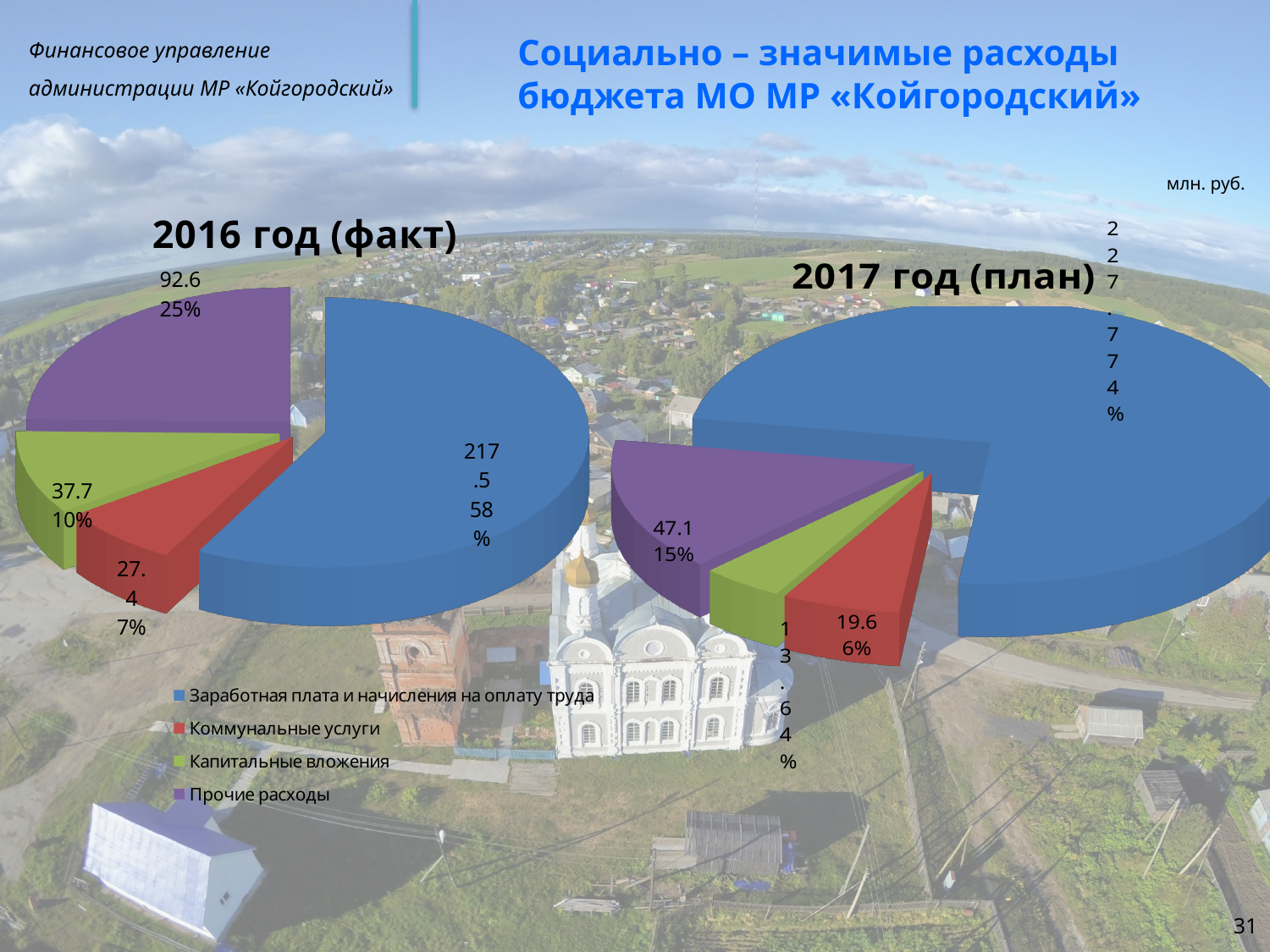
In the 2017 год (план) chart, what is the value for Прочие расходы? 47.1 In the 2016 год (факт) chart, what is the value for Заработная плата и начисления на оплату труда? 217.5 What unit is indicated for the values on the slide? млн. руб. In the 2017 год (план) chart, which category has the largest value? Заработная плата и начисления на оплату труда In the 2016 год (факт) chart, what share does Прочие расходы have? 25% In the 2016 год (факт) chart, which category has the smallest value? Коммунальные услуги In the 2016 год (факт) chart, what is the difference between Прочие расходы and Капитальные вложения? 54.9 In the 2017 год (план) chart, which is larger: Прочие расходы or Коммунальные услуги? Прочие расходы How many categories does the legend list? 4 In the 2017 год (план) chart, what share does Коммунальные услуги have? 6% In the 2016 год (факт) chart, what is the value for Коммунальные услуги? 27.4 What type of chart is used on this slide? Pie chart